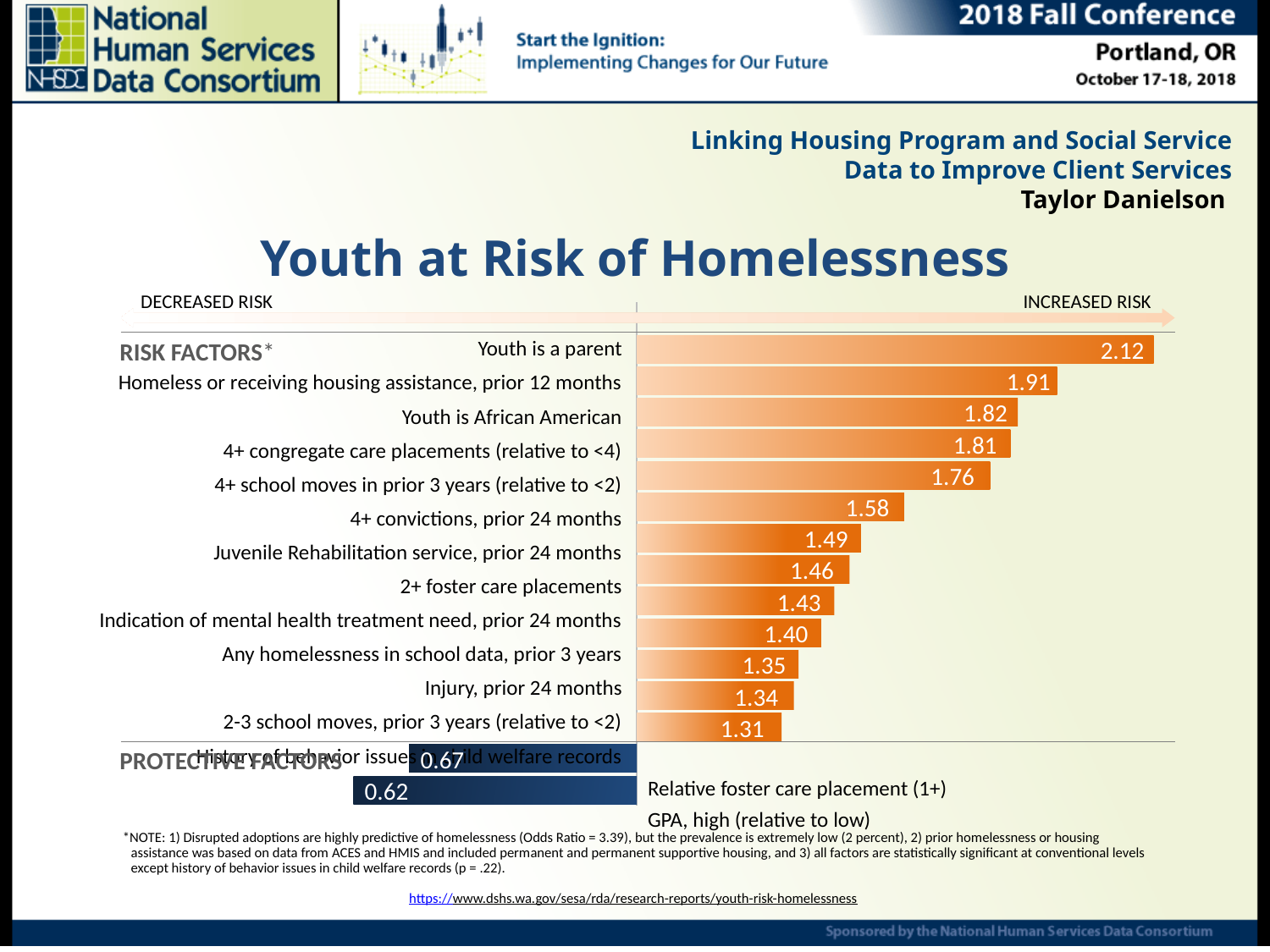
Which has a larger value: "4+ school moves in prior 3 years (relative to <2)" or "4+ convictions, prior 24 months"? 4+ school moves in prior 3 years (relative to <2) What is the title of the chart? Youth at Risk of Homelessness What is the lowest value shown in the chart? 0.62 What is the value shown for "Youth is a parent"? 2.12 How many bars are plotted in the chart in total? 15 What is the value shown for "Youth is African American"? 1.82 What is the difference between the values for "Youth is a parent" and "Homeless or receiving housing assistance, prior 12 months"? 0.21 What is the value shown for "Homeless or receiving housing assistance, prior 12 months"? 1.91 Which factor has the highest value in the chart? Youth is a parent What type of chart is shown on the slide? bar chart What is the value shown for "4+ convictions, prior 24 months"? 1.58 Do the risk factor values increase or decrease going down the chart from top to bottom? decrease